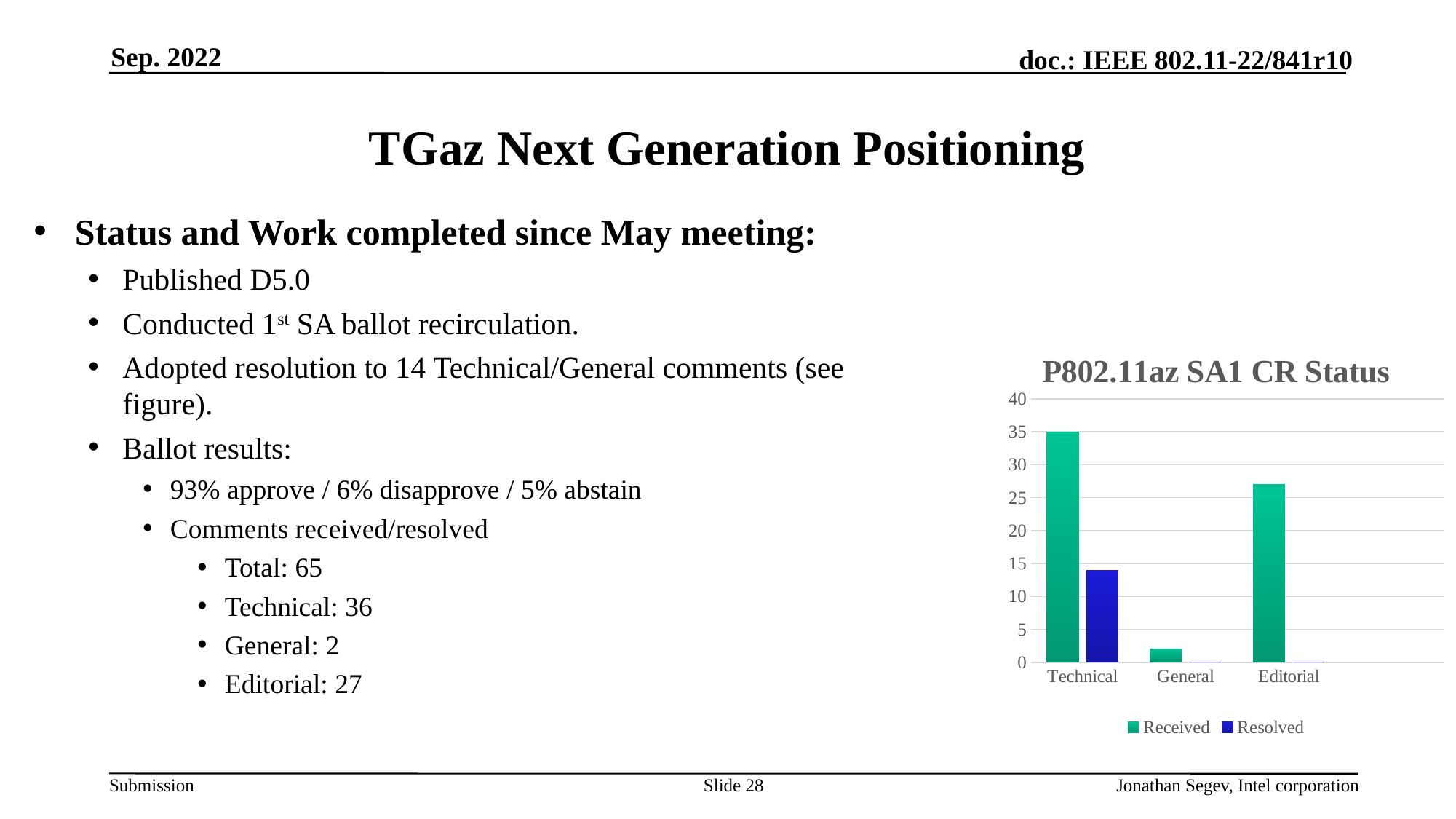
Which is larger in the chart: the Received value for Technical or the Received value for Editorial? Technical Is the Received value for General greater or less than 5? less Which category has the lowest Received value in the chart? General How many categories are shown on the x axis of the chart? 3 What kind of chart is shown on the slide? bar chart What is the title of the chart on the slide? P802.11az SA1 CR Status Is the Received value for Technical greater or less than 30? greater Which category has the highest Resolved value in the chart? Technical Is the Received value for Editorial greater or less than 25? greater Which category has the highest Received value in the chart? Technical How many series does the chart's legend list? 2